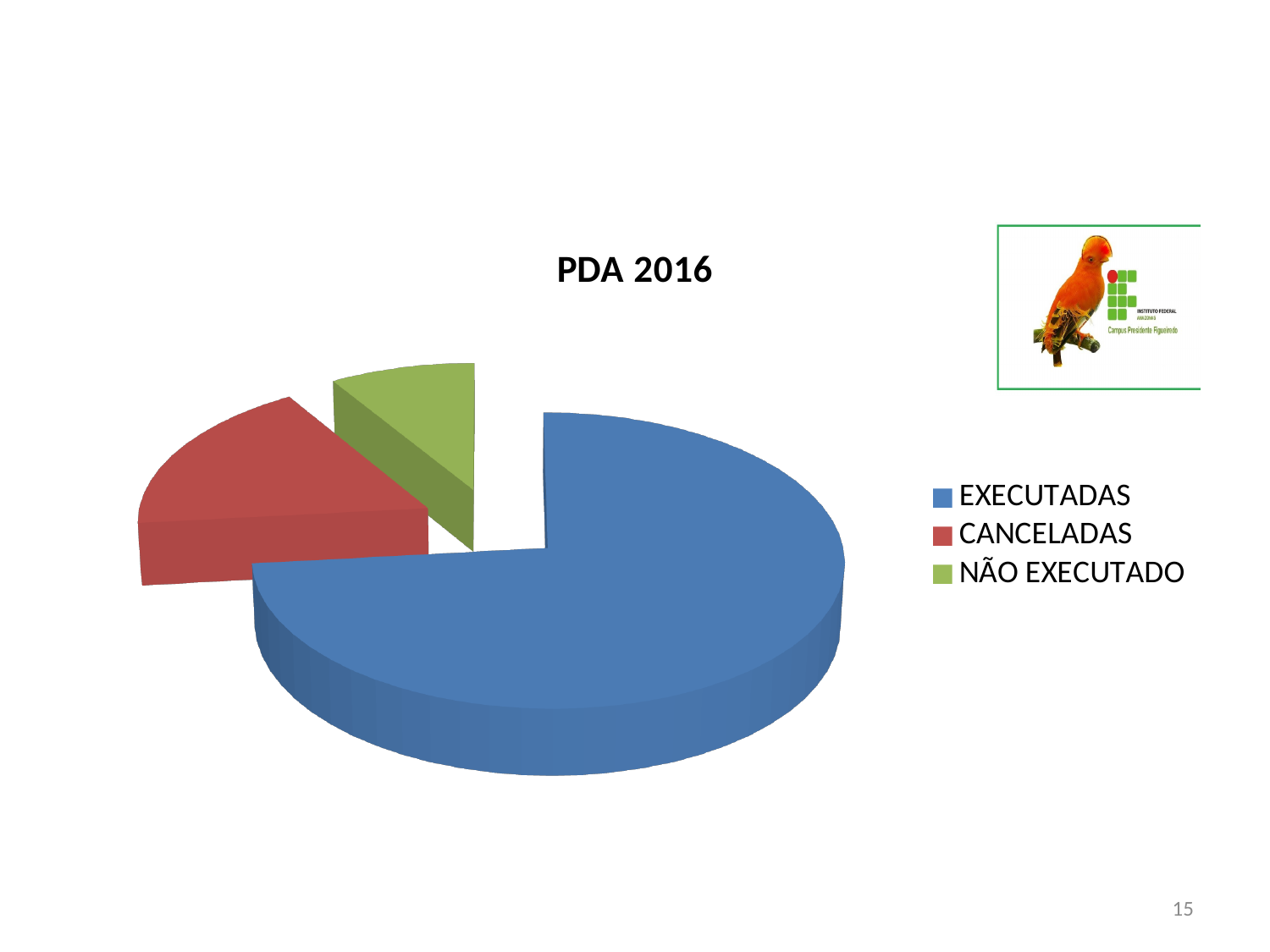
How many categories does the pie chart show? 3 What kind of chart is shown on the slide? pie chart Does the EXECUTADAS slice make up more or less than half of the pie? more Which category has the largest slice of the pie? EXECUTADAS Which slice is larger, CANCELADAS or NÃO EXECUTADO? CANCELADAS Which colour represents CANCELADAS in the chart? red Which slice is larger, EXECUTADAS or CANCELADAS? EXECUTADAS Which category has the smallest slice of the pie? NÃO EXECUTADO What is the title of the chart? PDA 2016